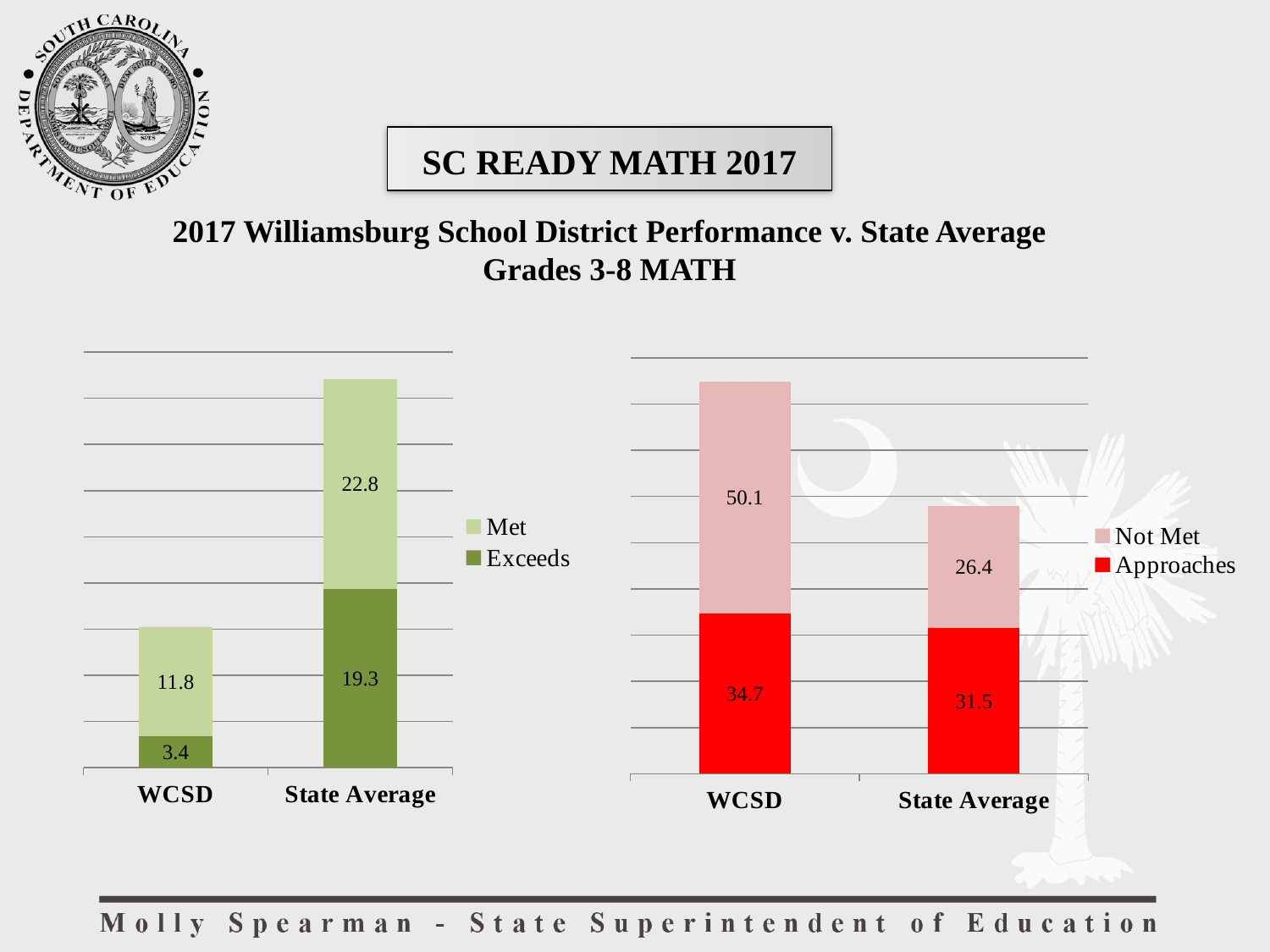
In the left chart (Met/Exceeds), what is the difference between the Met values for State Average and WCSD? 11.0 In the left chart (Met/Exceeds), which category has the lower Exceeds value? WCSD In the right chart (Not Met/Approaches), what is the Approaches value for State Average? 31.5 In the right chart (Not Met/Approaches), what is the difference between the Not Met values for WCSD and State Average? 23.7 In the left chart (Met/Exceeds), what is the Met value for WCSD? 11.8 In the right chart (Not Met/Approaches), what is the total height of the State Average stacked bar? 57.9 In the left chart (Met/Exceeds), what is the total height of the WCSD stacked bar? 15.2 In the right chart (Not Met/Approaches), what is the Not Met value for WCSD? 50.1 How many series does the legend of the right chart list? 2 In the right chart (Not Met/Approaches), which category has the higher Approaches value, WCSD or State Average? WCSD What kind of chart is the left chart (Met/Exceeds)? Stacked bar chart In the left chart (Met/Exceeds), what is the Exceeds value for State Average? 19.3